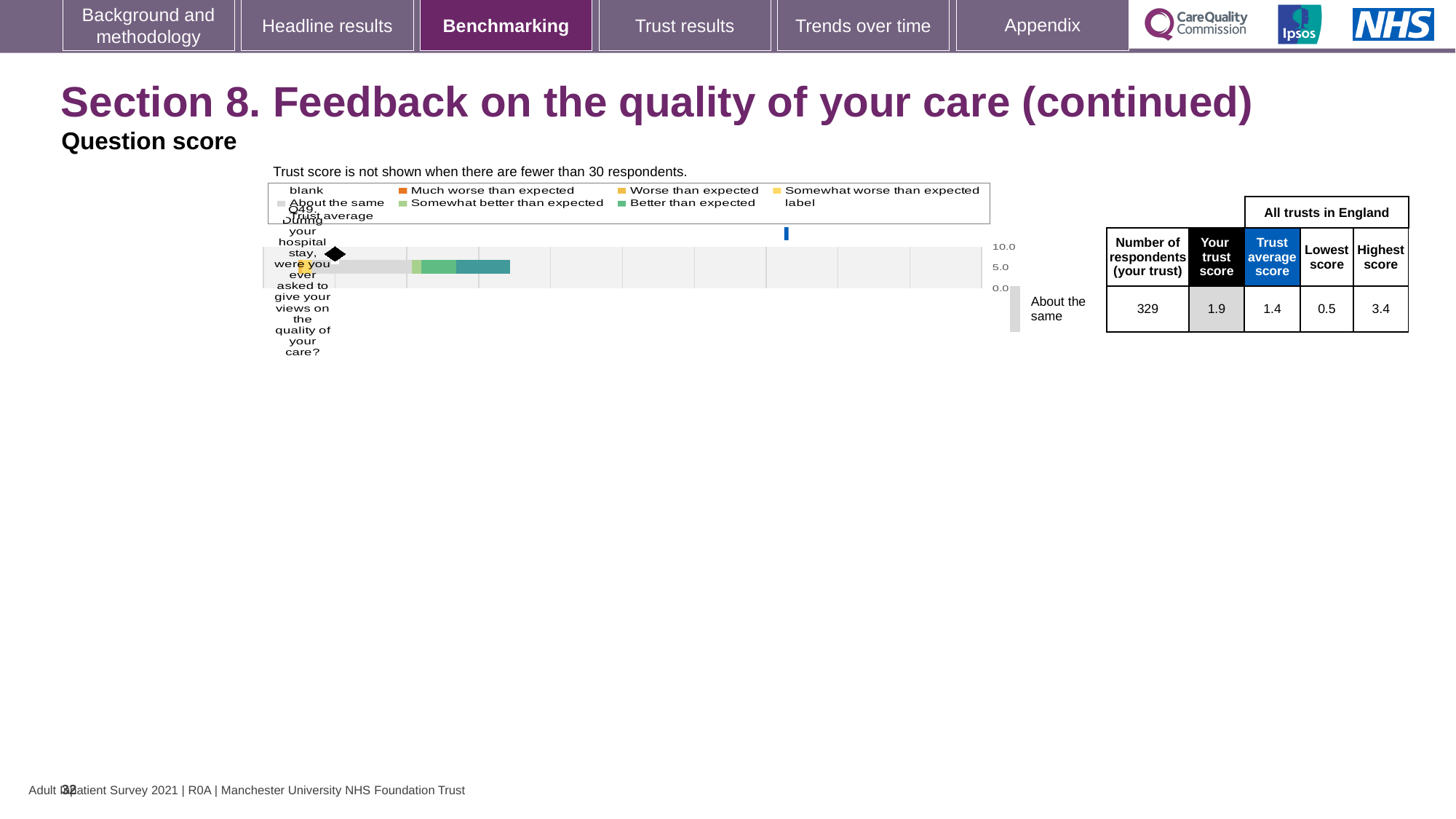
What benchmark category is shown next to the Q49 bar? About the same What is the highest score among all trusts in England for Q49? 3.4 What is the 'Your trust score' value for Q49? 1.9 How many respondents from your trust answered Q49? 329 What is the lowest score among all trusts in England for Q49? 0.5 What kind of chart is used to show the Q49 benchmarking result? bar chart Which question number is plotted in the benchmarking chart? Q49 What is the difference between the highest score and the lowest score for Q49? 2.9 How many questions are plotted in the benchmarking chart? 1 What is the 'Trust average score' for Q49? 1.4 Which is larger for Q49: your trust score or the trust average score? Your trust score Is your trust score for Q49 greater or less than 5.0? less